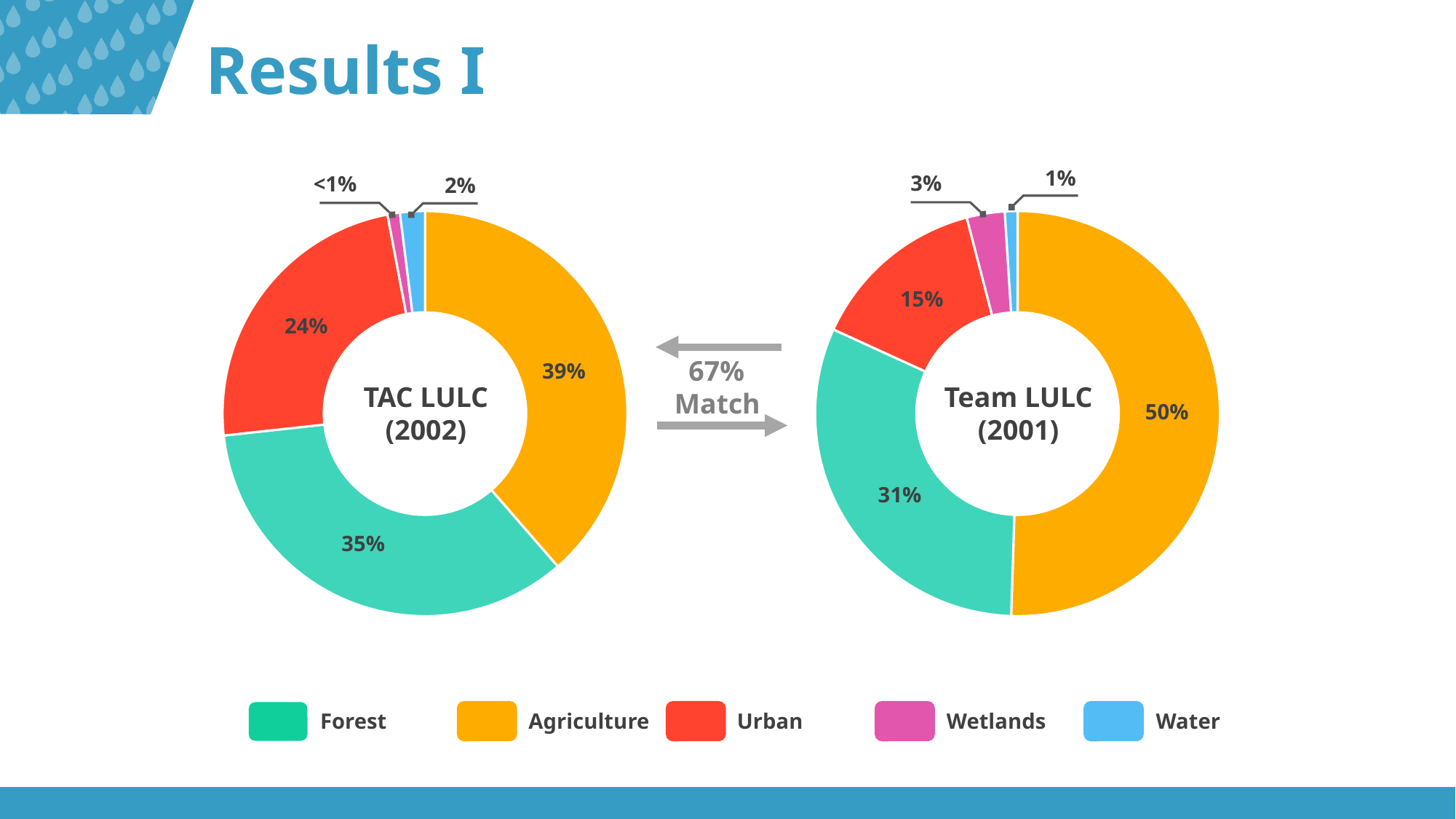
In the Team LULC (2001) chart, which category has the smallest share? Water How many categories does the legend list? 5 In the TAC LULC (2002) chart, which category has the smallest share? Wetlands In the Team LULC (2001) chart, which category has the largest share? Agriculture What kind of chart is used on this slide? Donut (pie) chart In the TAC LULC (2002) chart, what share is Water? 2% In the TAC LULC (2002) chart, what share is Urban? 24% What is the difference between the Agriculture share in the Team LULC (2001) chart and the Agriculture share in the TAC LULC (2002) chart? 11% In the TAC LULC (2002) chart, what share is Agriculture? 39% In the Team LULC (2001) chart, what share is Forest? 31% In the TAC LULC (2002) chart, which is larger, Forest or Urban? Forest In the Team LULC (2001) chart, what share is Wetlands? 3%